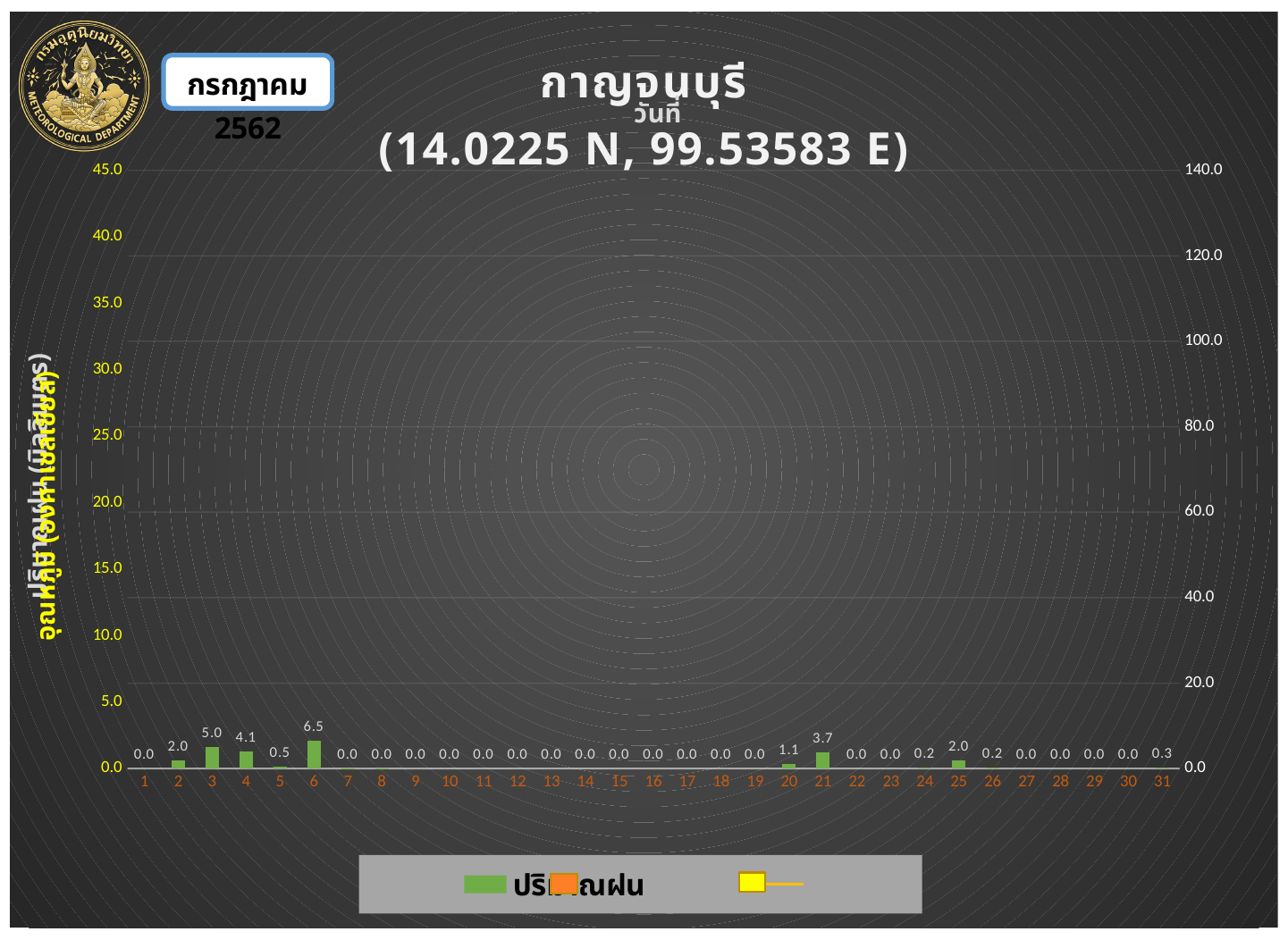
What is the difference between the rainfall values for day 6 and day 3? 1.5 What is the rainfall value shown for day 4? 4.1 What is the name of the station in the chart title? กาญจนบุรี Which is larger, the rainfall value for day 3 or for day 4? day 3 Is the rainfall value for day 6 greater or less than 5.0? greater What is the difference between the rainfall values for day 21 and day 20? 2.6 Which day has the highest rainfall value? 6 What kind of chart is shown on the slide? bar chart What is the rainfall value shown for day 21? 3.7 How many days are shown on the x axis? 31 What is the rainfall value shown for day 31? 0.3 What is the rainfall value shown for day 6? 6.5